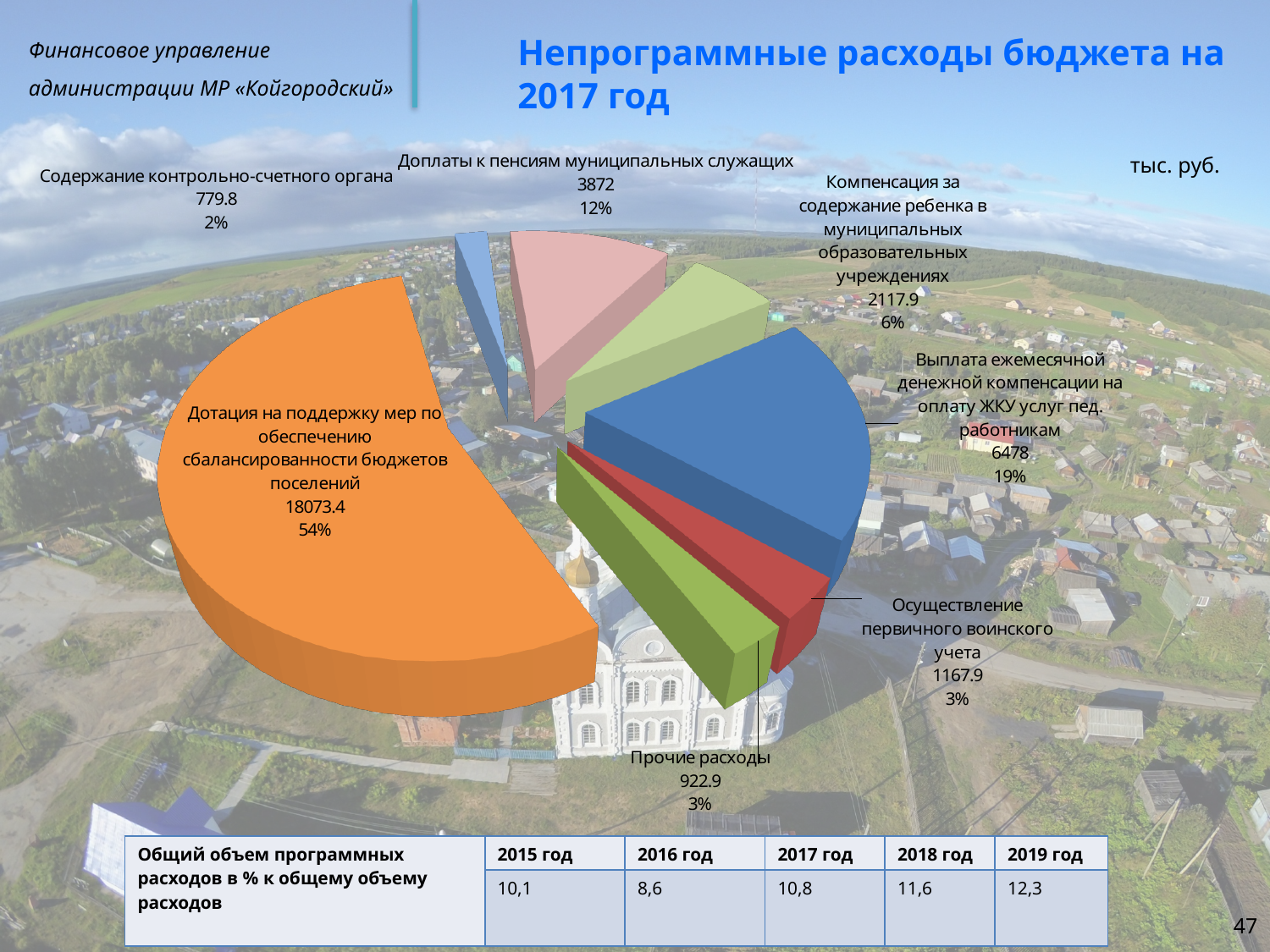
What is the value for "Доплаты к пенсиям муниципальных служащих"? 3872 What is the value for "Выплата ежемесячной денежной компенсации на оплату ЖКУ услуг пед. работникам"? 6478 Which category has the smallest slice of the pie? Содержание контрольно-счетного органа What kind of chart is shown on the slide? pie chart Which category has the largest slice of the pie? Дотация на поддержку мер по обеспечению сбалансированности бюджетов поселений How many slices does the pie chart have? 7 What share of the pie does "Компенсация за содержание ребенка в муниципальных образовательных учреждениях" represent? 6% What is the difference between the values for "Осуществление первичного воинского учета" and "Прочие расходы"? 245 What is the value for "Содержание контрольно-счетного органа"? 779.8 What is the value for "Дотация на поддержку мер по обеспечению сбалансированности бюджетов поселений"? 18073.4 What is the title of the chart on the slide? Непрограммные расходы бюджета на 2017 год Which is larger: the value for "Доплаты к пенсиям муниципальных служащих" or for "Компенсация за содержание ребенка в муниципальных образовательных учреждениях"? Доплаты к пенсиям муниципальных служащих